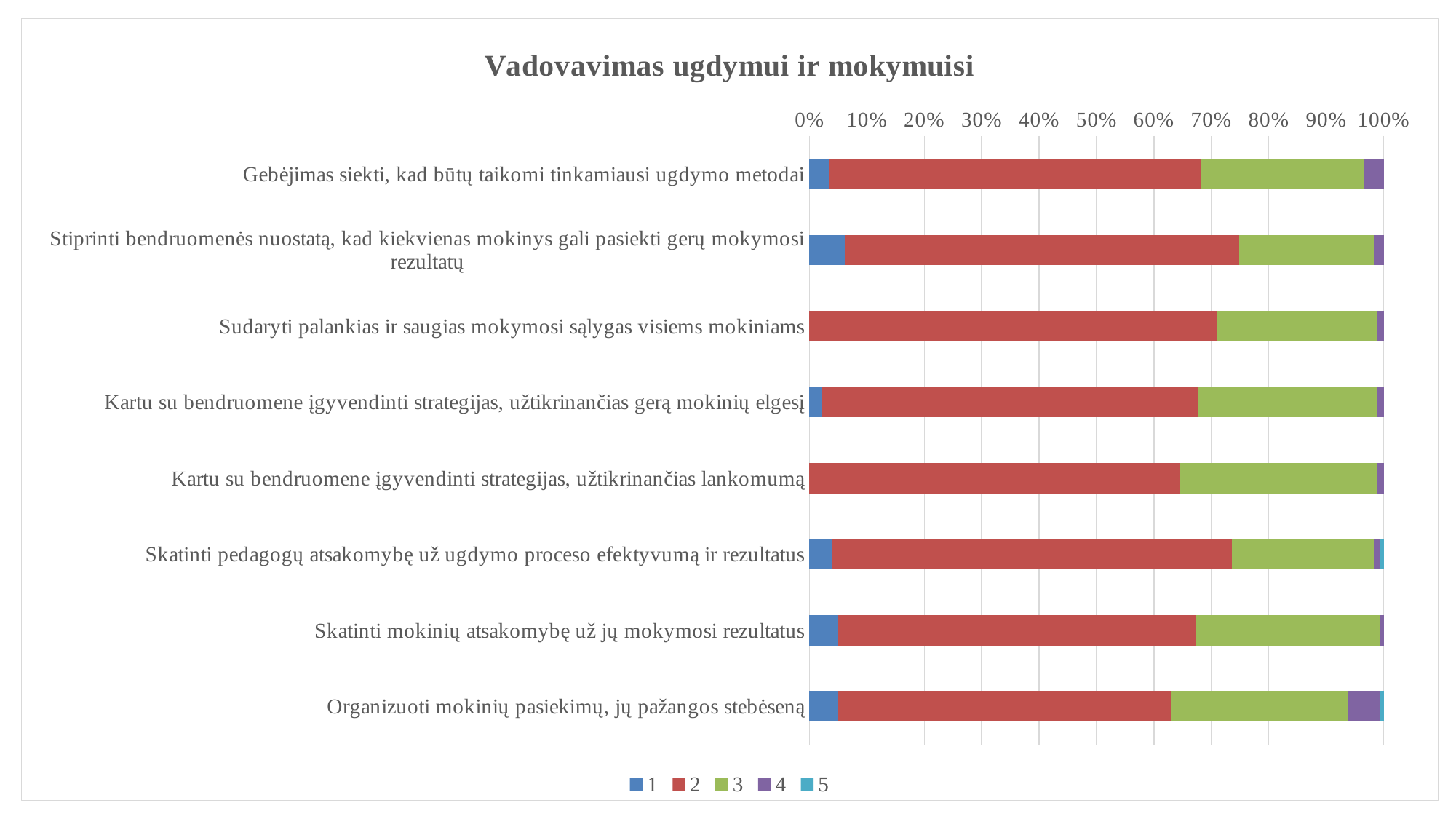
Which series occupies the largest share of every bar in the chart? 2 Is the share of series 2 for "Gebėjimas siekti, kad būtų taikomi tinkamiausi ugdymo metodai" greater or less than 50%? greater How many categories (bars) are plotted in the chart? 8 What kind of chart is shown on the slide? Stacked bar chart Which category has the largest share of series 4? Organizuoti mokinių pasiekimų, jų pažangos stebėseną Is the share of series 2 for "Stiprinti bendruomenės nuostatą, kad kiekvienas mokinys gali pasiekti gerų mokymosi rezultatų" greater or less than 60%? greater Is the share of series 3 for "Organizuoti mokinių pasiekimų, jų pažangos stebėseną" greater or less than 40%? less For "Gebėjimas siekti, kad būtų taikomi tinkamiausi ugdymo metodai", which is larger: the share of series 2 or the share of series 3? Series 2 How many categories show a visible segment for series 1? 6 What is the title of the chart? Vadovavimas ugdymui ir mokymuisi How many series does the legend list? 5